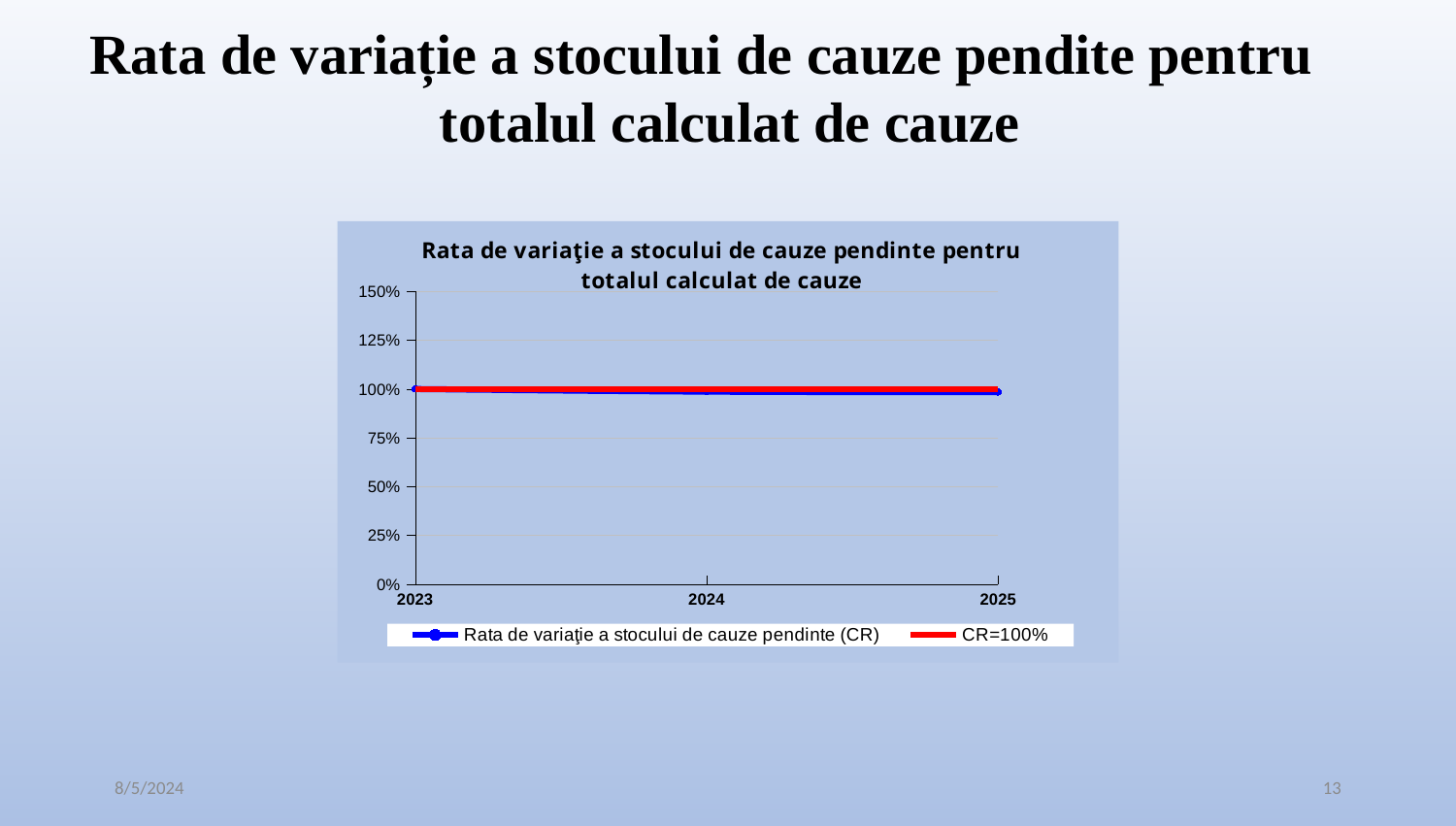
How many years are shown on the x axis of the chart? 3 Is the value of the blue series (Rata de variație a stocului de cauze pendinte (CR)) in 2024 greater or less than 50%? greater What is the name of the series drawn in red in the chart? CR=100% Is the value of the blue series (Rata de variație a stocului de cauze pendinte (CR)) in 2025 greater or less than 125%? less Is the value of the blue series (Rata de variație a stocului de cauze pendinte (CR)) in 2023 greater or less than 75%? greater Which years are shown on the x axis of the chart? 2023, 2024, 2025 What constant value does the red reference line in the chart represent? 100% What kind of chart is shown on the slide? line chart What is the highest value shown on the y axis of the chart? 150% How many series does the chart legend list? 2